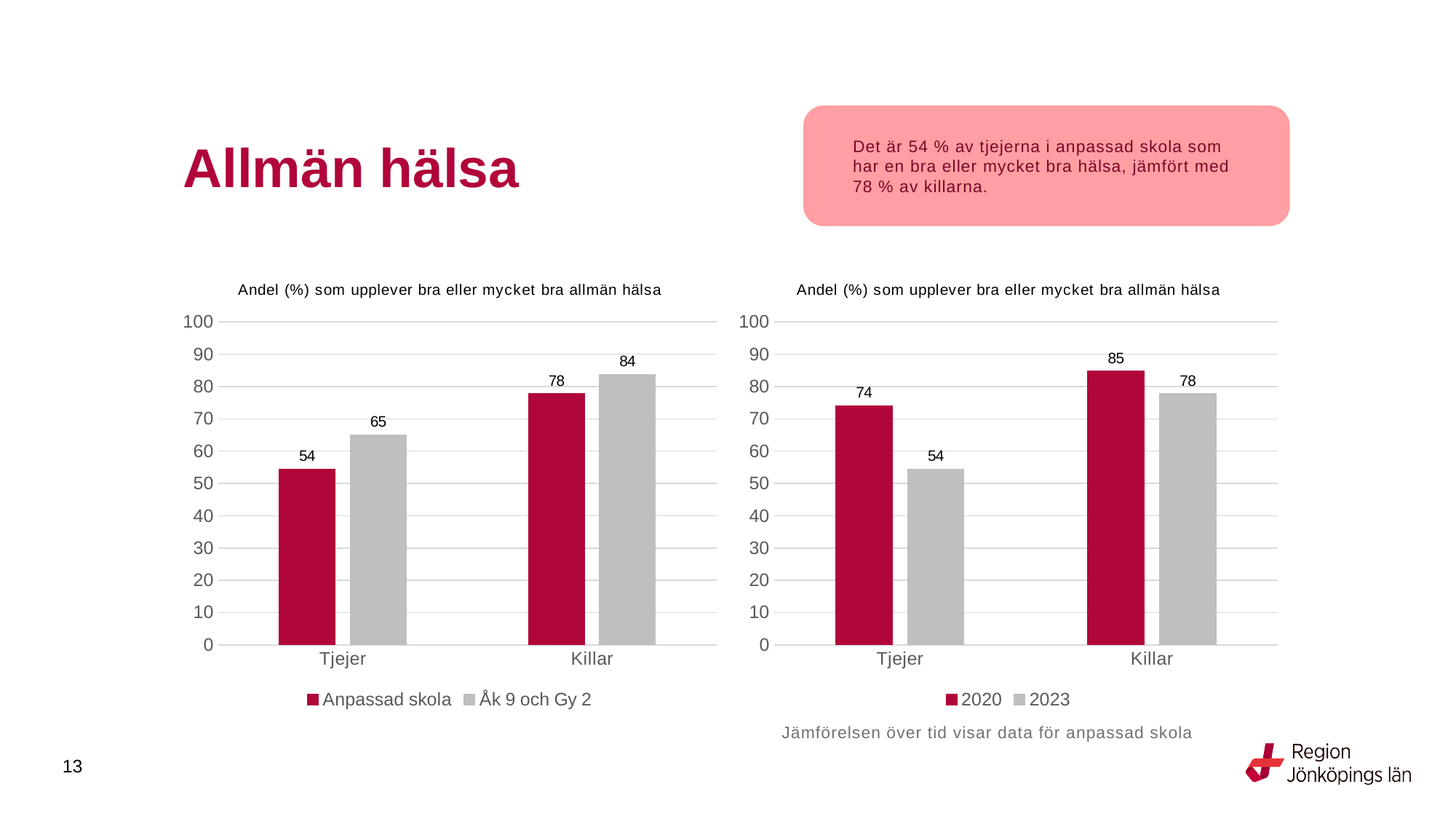
In the right chart, what is the value for Tjejer in 2023? 54 In the left chart, what is the value for Killar in the Åk 9 och Gy 2 series? 84 What are the two series named in the legend of the left chart? Anpassad skola and Åk 9 och Gy 2 What kind of chart is the left chart? Bar chart In the right chart, by how much did the value for Tjejer fall from 2020 to 2023? 20 In the left chart, what is the difference between Killar and Tjejer in the Anpassad skola series? 24 In the right chart, which bar has the lowest value? Tjejer 2023 In the right chart, what is the value for Killar in 2020? 85 How many series does the legend of the right chart list? 2 In the left chart, which category has the highest value in the Åk 9 och Gy 2 series? Killar In the right chart, which is larger for Killar: 2020 or 2023? 2020 In the left chart, what is the value for Tjejer in the Anpassad skola series? 54